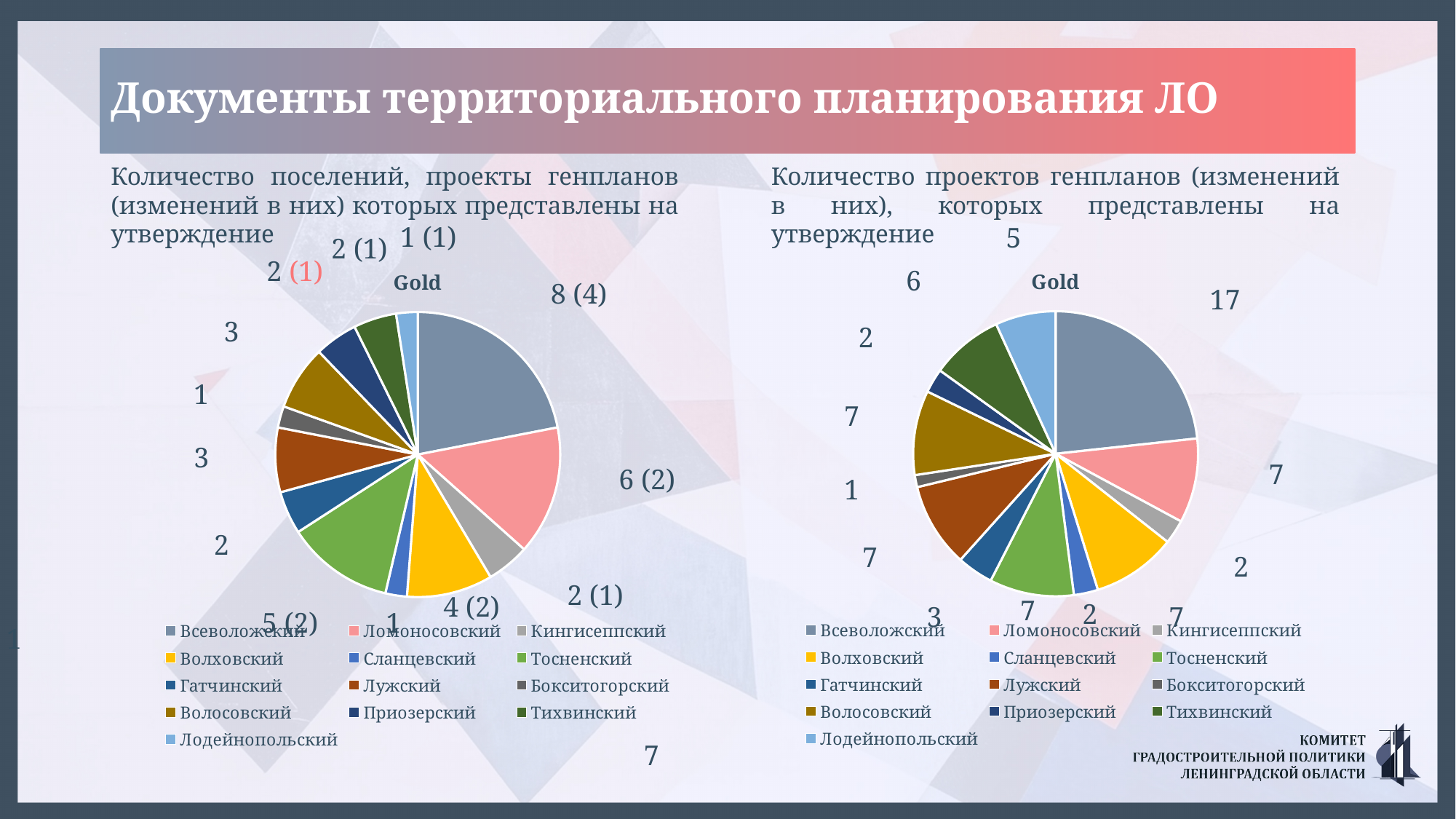
In the right pie chart (Количество проектов генпланов), which category has the smallest slice? Бокситогорский In the right pie chart (Количество проектов генпланов), which category has the largest slice? Всеволожский In the right pie chart (Количество проектов генпланов), what is the difference between Всеволожский (17) and Ломоносовский (7)? 10 In the left pie chart (Количество поселений), which category has the largest slice? Всеволожский What kind of chart is used on the right side of the slide? pie chart In the right pie chart (Количество проектов генпланов), what is the value for Лодейнопольский? 5 In the right pie chart (Количество проектов генпланов), what is the value for Тихвинский? 6 In the right pie chart (Количество проектов генпланов), which is larger: Всеволожский or Ломоносовский? Всеволожский How many categories does the legend of the right pie chart list? 13 In the right pie chart (Количество проектов генпланов), what is the value for Всеволожский? 17 In the left pie chart (Количество поселений), what is the data label for Всеволожский? 8 (4) What kind of chart is used on the left side of the slide? pie chart